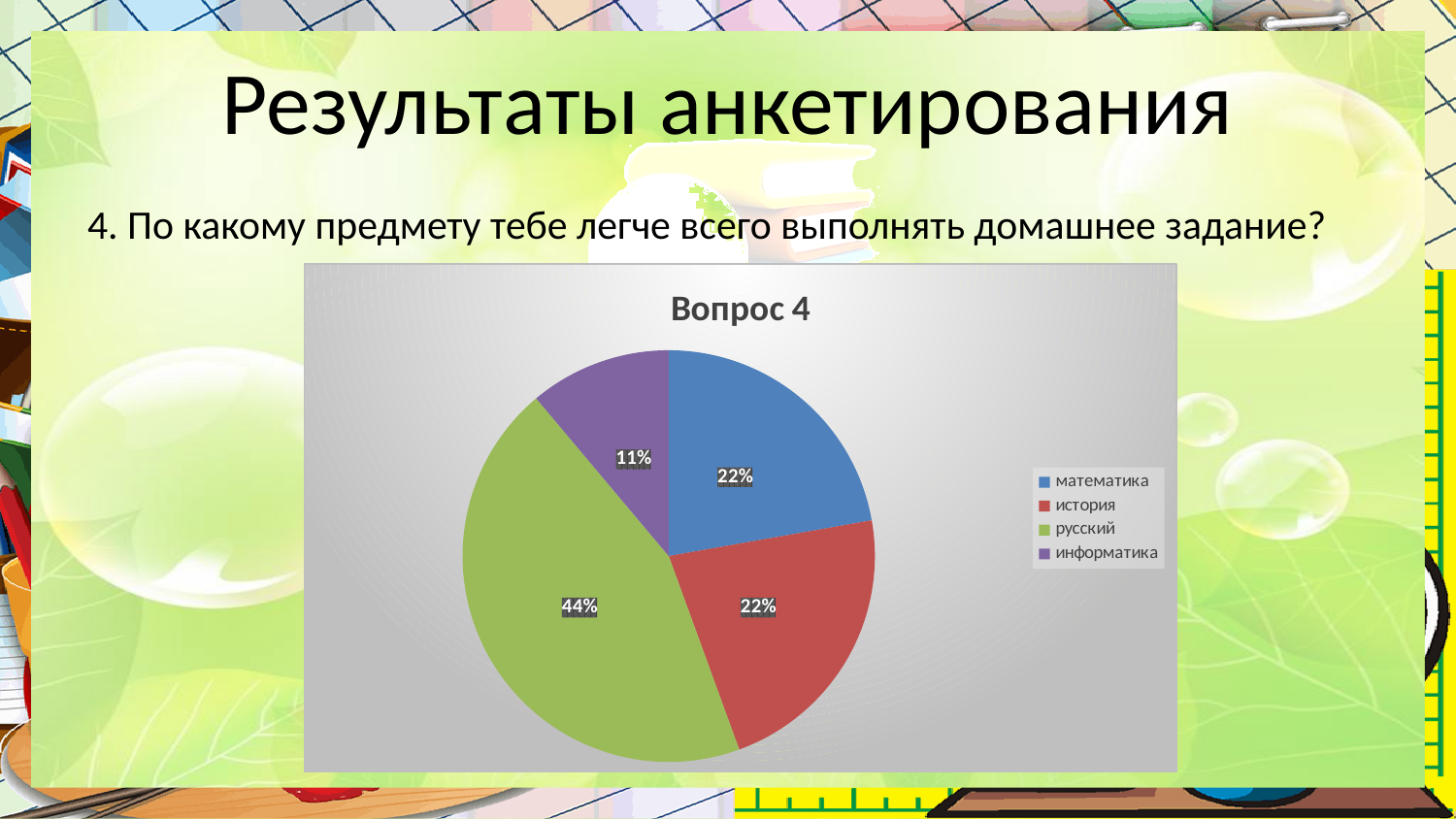
Which subject has the smallest slice of the pie? информатика What share of the pie does история have? 22% What share of the pie does математика have? 22% Which subject has the largest slice of the pie? русский What kind of chart is shown on the slide? pie chart What share of the pie does русский have? 44% What is the title of the chart? Вопрос 4 Which colour represents история in the chart? red How many categories does the legend list? 4 Which is larger, the slice for русский or the slice for информатика? русский What is the difference in percentage points between the русский slice and the информатика slice? 33